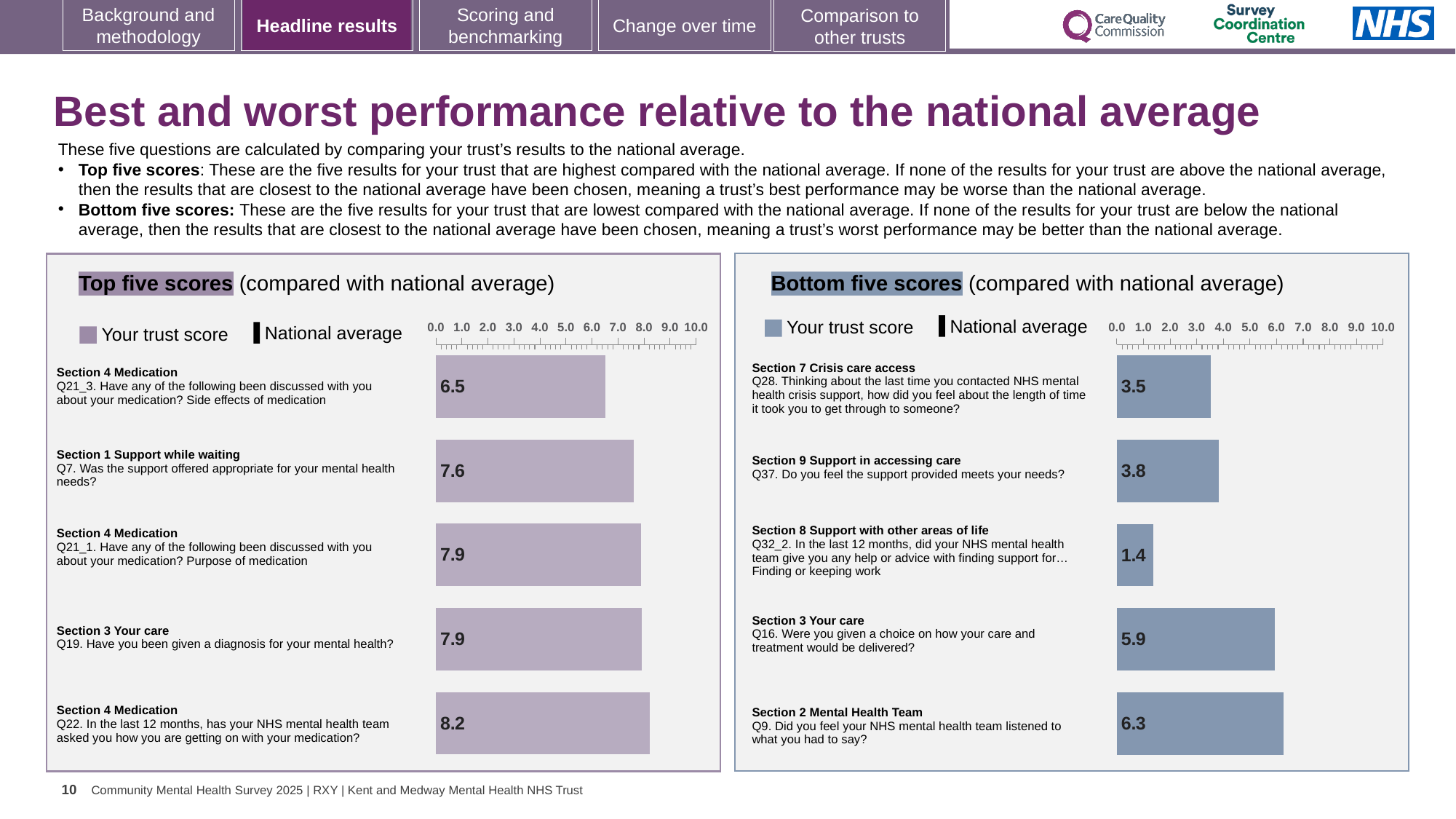
In the Bottom five scores chart, what is the difference between the trust scores for Q16 and Q28? 2.4 In the Bottom five scores chart, what is the trust score for Q32_2 (help or advice with finding or keeping work)? 1.4 In the Bottom five scores chart, what is the trust score for Q9 (did your mental health team listen to what you had to say)? 6.3 In the Bottom five scores chart, which question has the highest trust score? Q9 (Did you feel your NHS mental health team listened to what you had to say?) How many entries does the legend of the Top five scores chart list? 2 What type of chart is the Top five scores chart? Bar chart In the Top five scores chart, which question has the lowest trust score? Q21_3 (Side effects of medication) In the Top five scores chart, what is the trust score for Q7 (was the support offered appropriate for your mental health needs)? 7.6 In the Top five scores chart, what is the trust score for Q22 (asked how you are getting on with your medication)? 8.2 How many bars are plotted in the Bottom five scores chart? 5 In the Bottom five scores chart, which has the larger trust score, Q37 or Q28? Q37 In the Top five scores chart, what is the difference between the trust scores for Q22 and Q21_3? 1.7